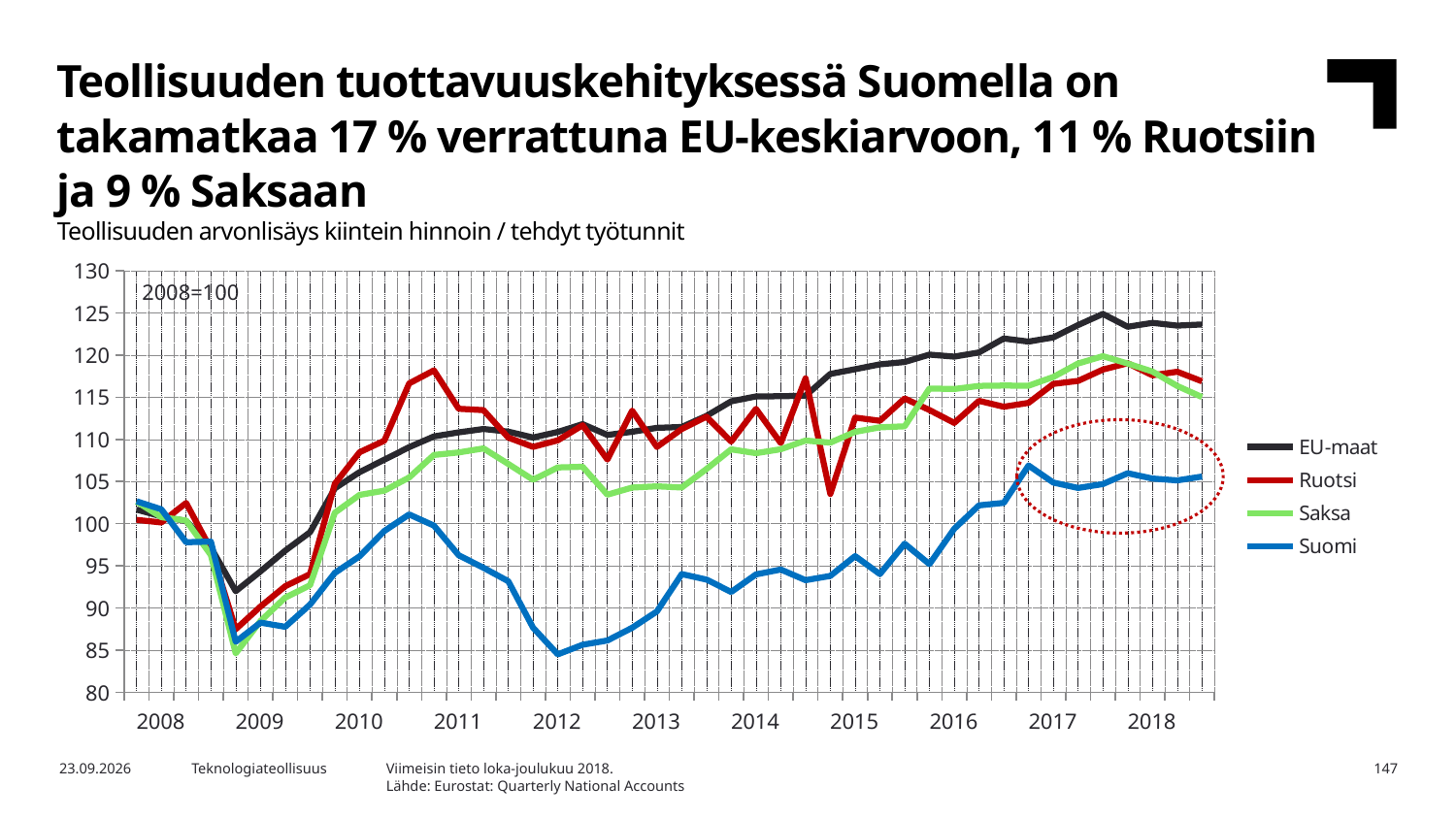
Is the lowest value for Suomi in 2012 greater or less than 90? less Is the value for EU-maat at the end of 2018 greater or less than 120? greater How many series does the legend list? 4 What kind of chart is shown on the slide? Line chart Does the EU-maat series rise or fall from 2010 to 2018? rise Which series has the lowest value at the end of 2018? Suomi How many year labels are shown on the x axis? 11 At the end of 2018, which is larger: the value for EU-maat or the value for Suomi? EU-maat What base year and value is the index set to, according to the note on the chart? 2008=100 Is the value for Suomi at the end of 2018 greater or less than 100? greater Which series are listed in the legend? EU-maat, Ruotsi, Saksa, Suomi Which series has the highest value at the end of 2018? EU-maat